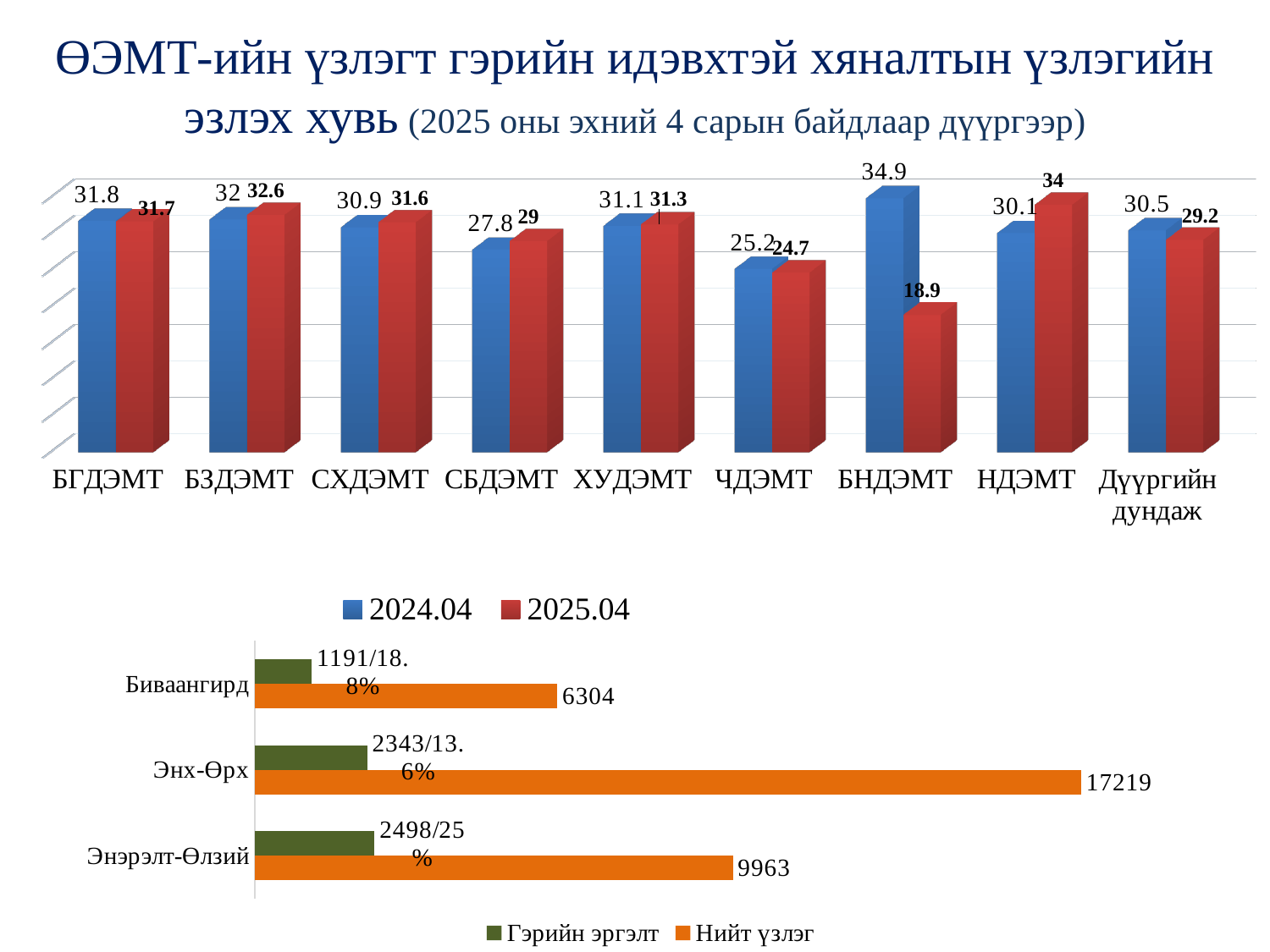
In the top chart, what is the difference between the 2024.04 and 2025.04 values for БНДЭМТ? 16 How many categories are shown on the x axis of the top chart? 9 In the bottom chart, what is the Нийт үзлэг value for Энх-Өрх? 17219 In the top chart, what is the 2025.04 value for НДЭМТ? 34 How many series does the legend of the top chart list? 2 What kind of chart is the bottom chart? Bar chart In the top chart, which is larger for СБДЭМТ: the 2024.04 value or the 2025.04 value? 2025.04 In the top chart, which category has the highest 2024.04 value? БНДЭМТ In the top chart, which category has the lowest 2025.04 value? БНДЭМТ In the bottom chart, what is the difference between the Нийт үзлэг values for Энх-Өрх and Энэрэлт-Өлзий? 7256 In the bottom chart, which category has the lowest Нийт үзлэг value? Биваангирд In the top chart, what is the 2024.04 value for БНДЭМТ? 34.9